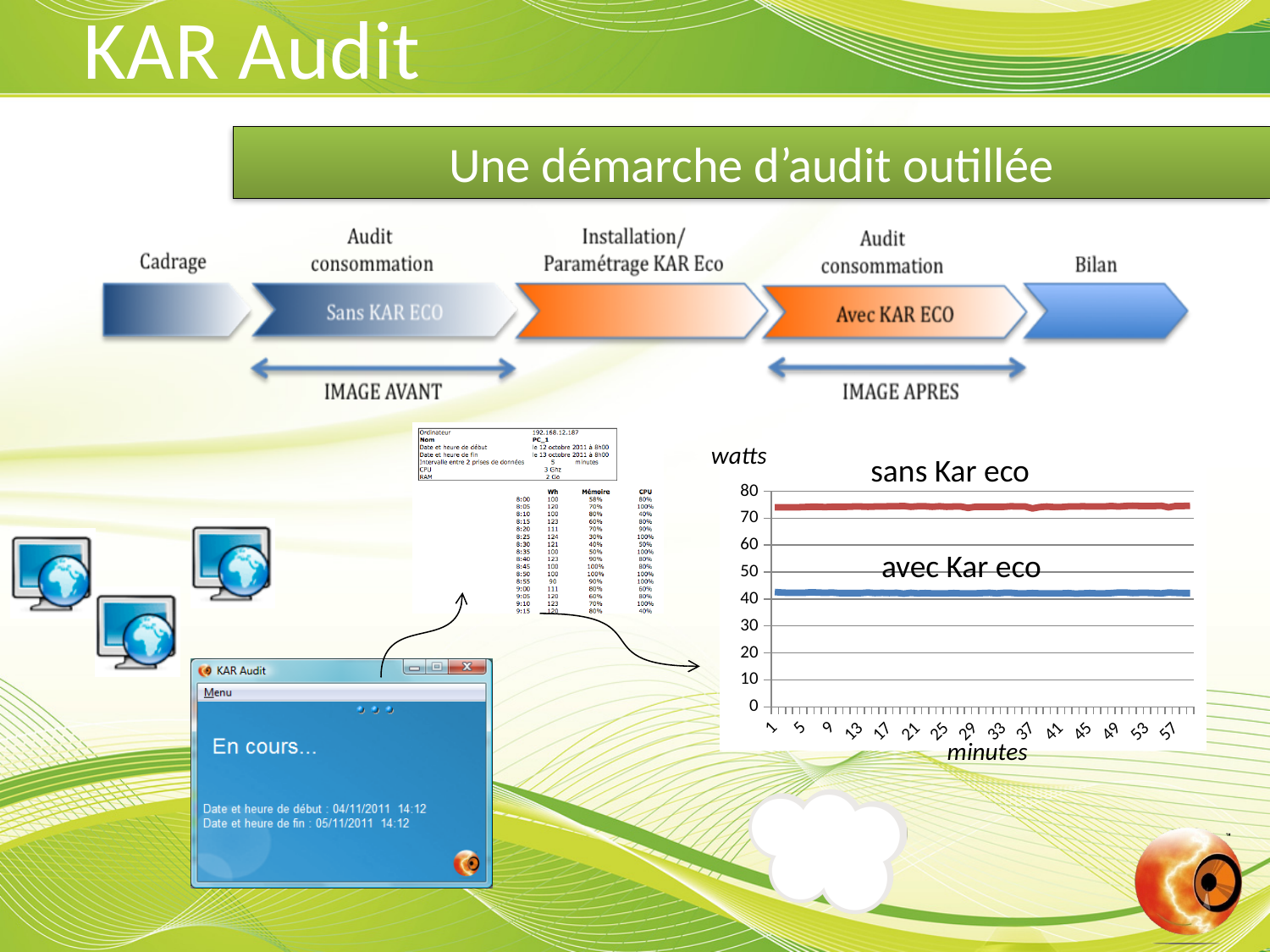
Is the value for 'avec Kar eco' greater or less than 30? greater What unit is shown on the horizontal axis of the chart? minutes Which series has the higher values, 'sans Kar eco' or 'avec Kar eco'? sans Kar eco Do the values of the 'avec Kar eco' series rise, fall or stay roughly flat along the x axis? stay roughly flat What unit is shown on the vertical axis of the chart? watts Is the value for 'sans Kar eco' greater or less than 80? less Do the values of the 'sans Kar eco' series rise, fall or stay roughly flat along the x axis? stay roughly flat Is the value for 'avec Kar eco' greater or less than 50? less What kind of chart is shown on the slide? line chart How many data series are plotted on the chart? 2 What is the highest value shown on the vertical axis of the chart? 80